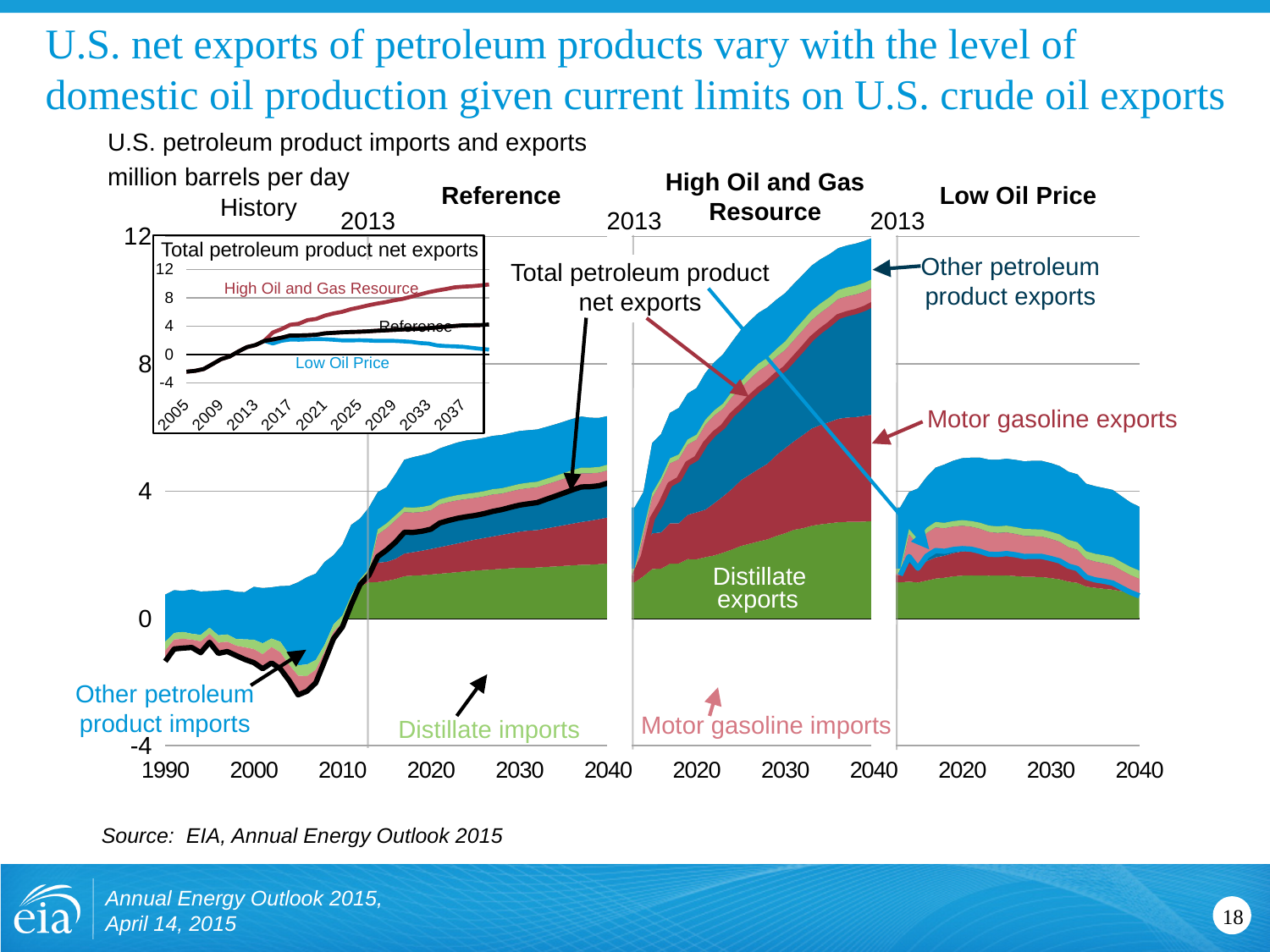
In the inset chart, do High Oil and Gas Resource net exports rise or fall from 2013 to 2037? rise What unit is shown on the y axis of the main chart? million barrels per day In the main chart, is the total petroleum product net exports value in 2005 greater or less than 0? less How many projection scenarios are shown in the main chart? 3 In the inset chart 'Total petroleum product net exports', which scenario has the lowest net exports in 2037? Low Oil Price In the inset chart, is the High Oil and Gas Resource net exports value in 2037 greater or less than 8? greater In the inset chart 'Total petroleum product net exports', which scenario has the highest net exports in 2037? High Oil and Gas Resource In the inset chart, do Low Oil Price net exports rise or fall from 2029 to 2037? fall How many scenario lines does the inset chart 'Total petroleum product net exports' show? 3 What kind of chart is the main chart on the slide? stacked area chart In the main chart, is the Low Oil Price total petroleum product net exports value in 2040 greater or less than 4? less In 2040, which scenario has larger total petroleum product net exports: High Oil and Gas Resource or Low Oil Price? High Oil and Gas Resource